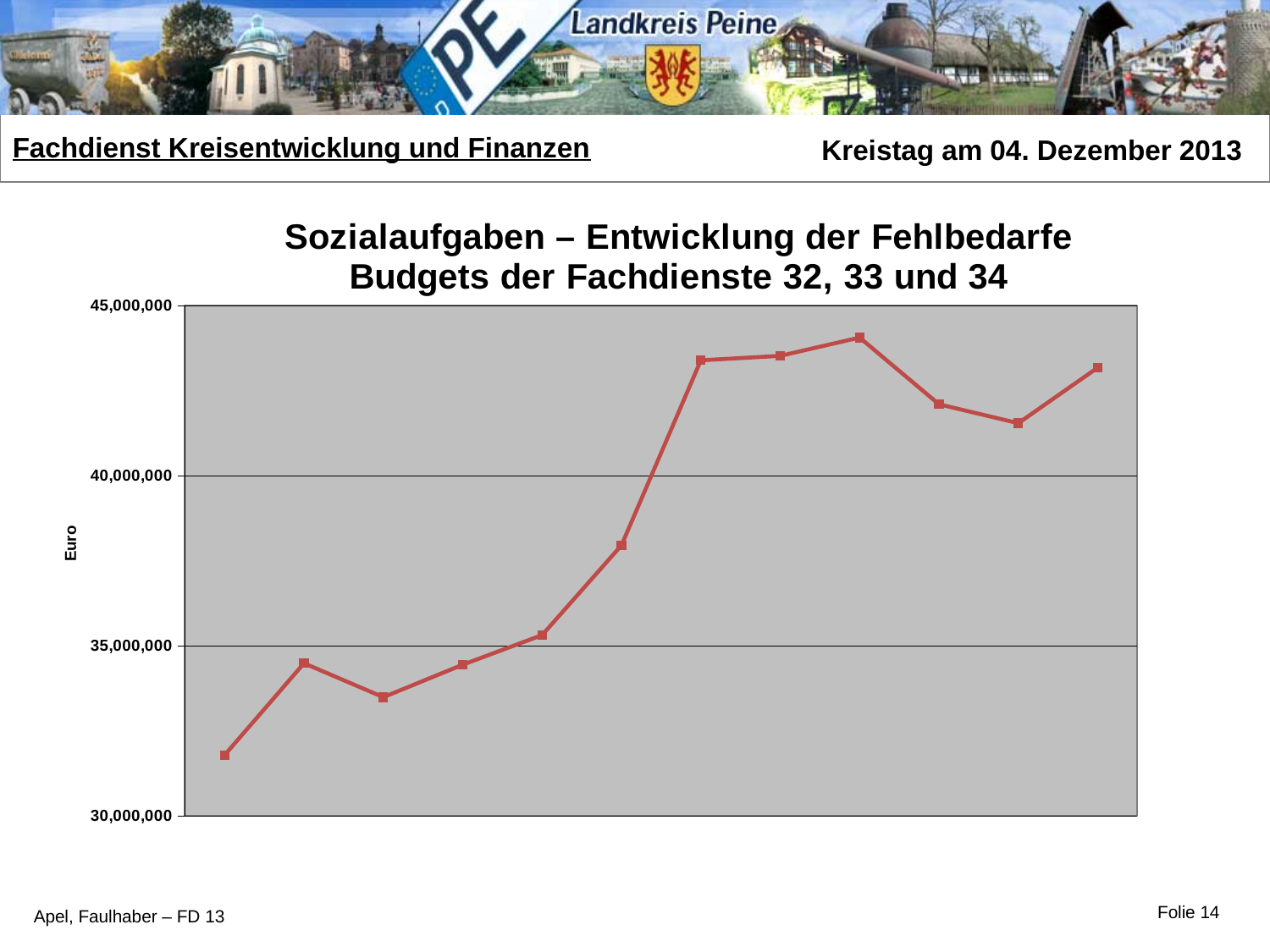
How many data points are plotted on the line? 12 What is the title of the chart? Sozialaufgaben – Entwicklung der Fehlbedarfe Budgets der Fachdienste 32, 33 und 34 Do the values overall rise or fall from the first point to the last point along the x axis? rise Is the value of the first data point greater or less than 35,000,000? less Is the value of the seventh data point greater or less than 40,000,000? greater What kind of chart is shown on the slide? line chart Which data point on the line has the lowest value? the first point Is the value of the sixth data point greater or less than 40,000,000? less Which data point on the line has the highest value? the ninth point What is the label on the vertical axis of the chart? Euro